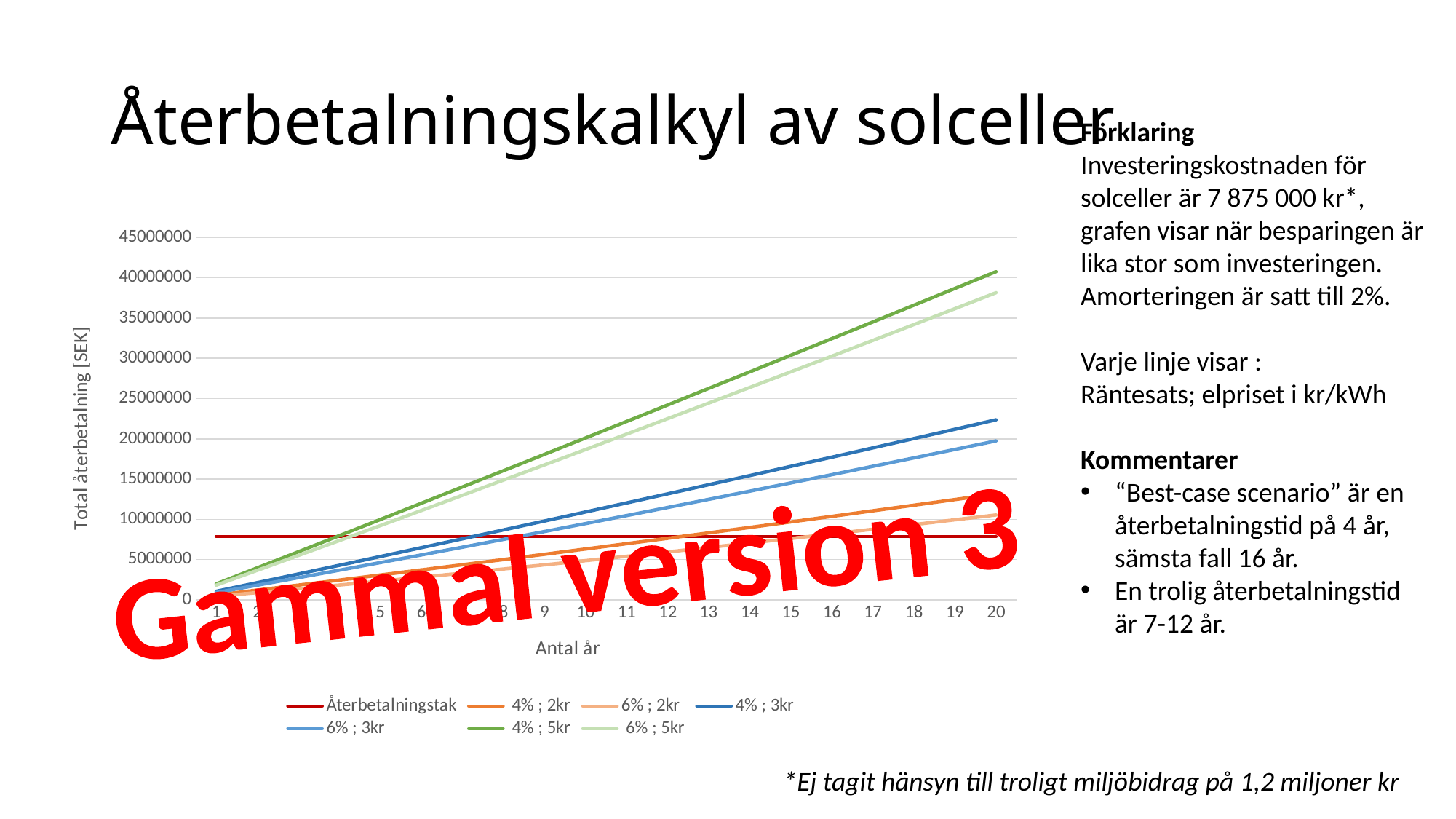
Is the value for 4% ; 5kr at year 20 greater or less than 35000000? greater Is the value for 4% ; 2kr at year 20 greater or less than 15000000? less Which series has the highest value at year 20? 4% ; 5kr Do the values for 6% ; 5kr rise or fall as the number of years increases? rise Which series has the lowest value at year 20? Återbetalningstak Is the value of the Återbetalningstak line greater or less than 10000000? less What kind of chart is shown on the slide? line chart How many years are shown along the x axis of the chart? 20 What is the title of the chart's x axis? Antal år How many series does the chart legend list? 7 At year 20, which is larger: 4% ; 3kr or 6% ; 3kr? 4% ; 3kr